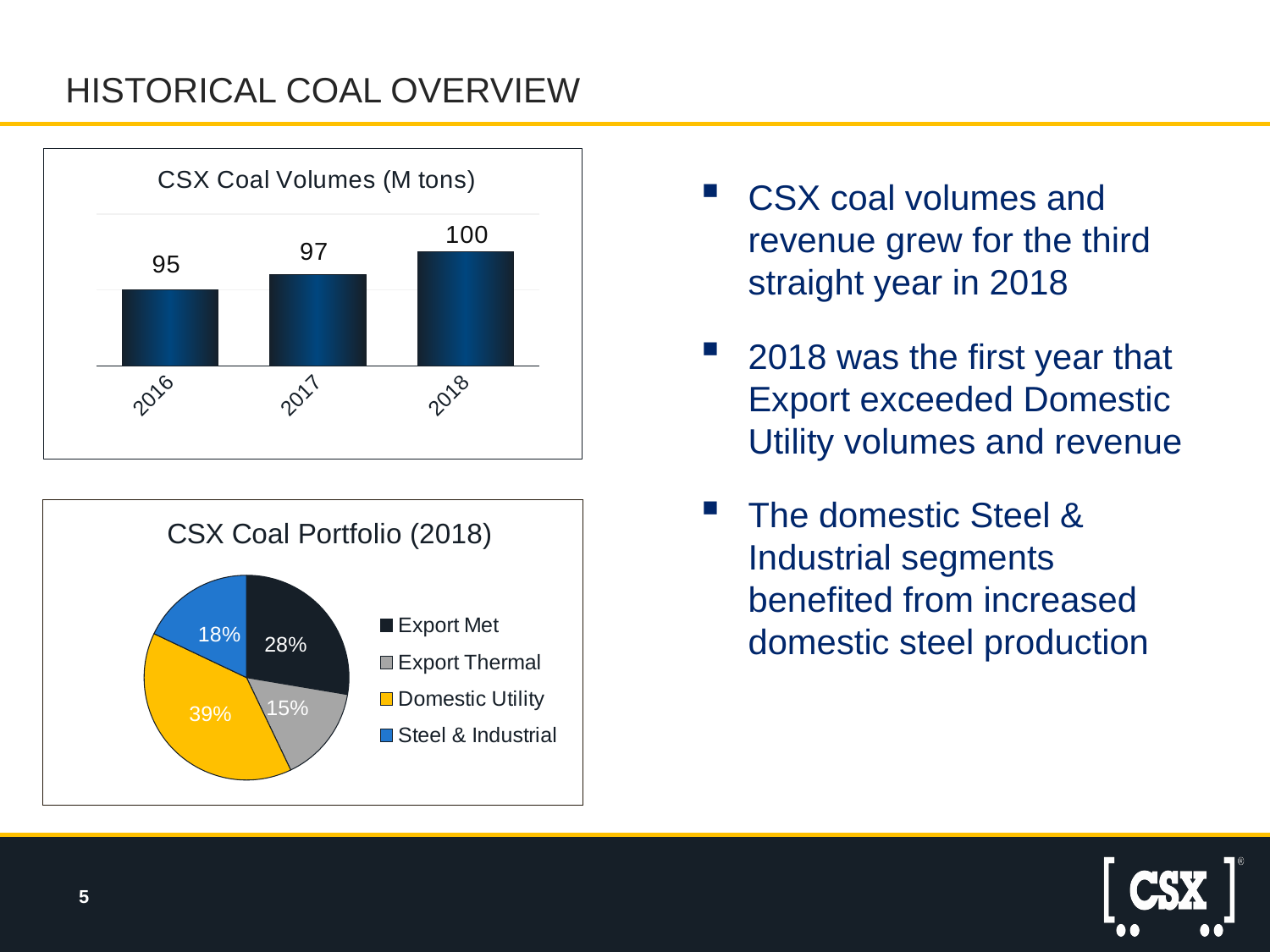
In the CSX Coal Portfolio (2018) chart, what share does Domestic Utility have? 39% In the CSX Coal Volumes (M tons) chart, which year has the lowest volume? 2016 In the CSX Coal Portfolio (2018) chart, how many segments does the legend list? 4 In the CSX Coal Volumes (M tons) chart, how many years are shown? 3 In the CSX Coal Volumes (M tons) chart, what is the value for 2016? 95 In the CSX Coal Volumes (M tons) chart, what is the difference between the 2018 and 2016 values? 5 In the CSX Coal Volumes (M tons) chart, what is the value for 2018? 100 In the CSX Coal Portfolio (2018) chart, which segment has the largest share? Domestic Utility In the CSX Coal Portfolio (2018) chart, which is larger, Export Met or Steel & Industrial? Export Met What kind of chart is the CSX Coal Volumes (M tons) chart? bar chart In the CSX Coal Portfolio (2018) chart, what is the value for Export Thermal? 15% In the CSX Coal Volumes (M tons) chart, do the values rise or fall from 2016 to 2018? rise